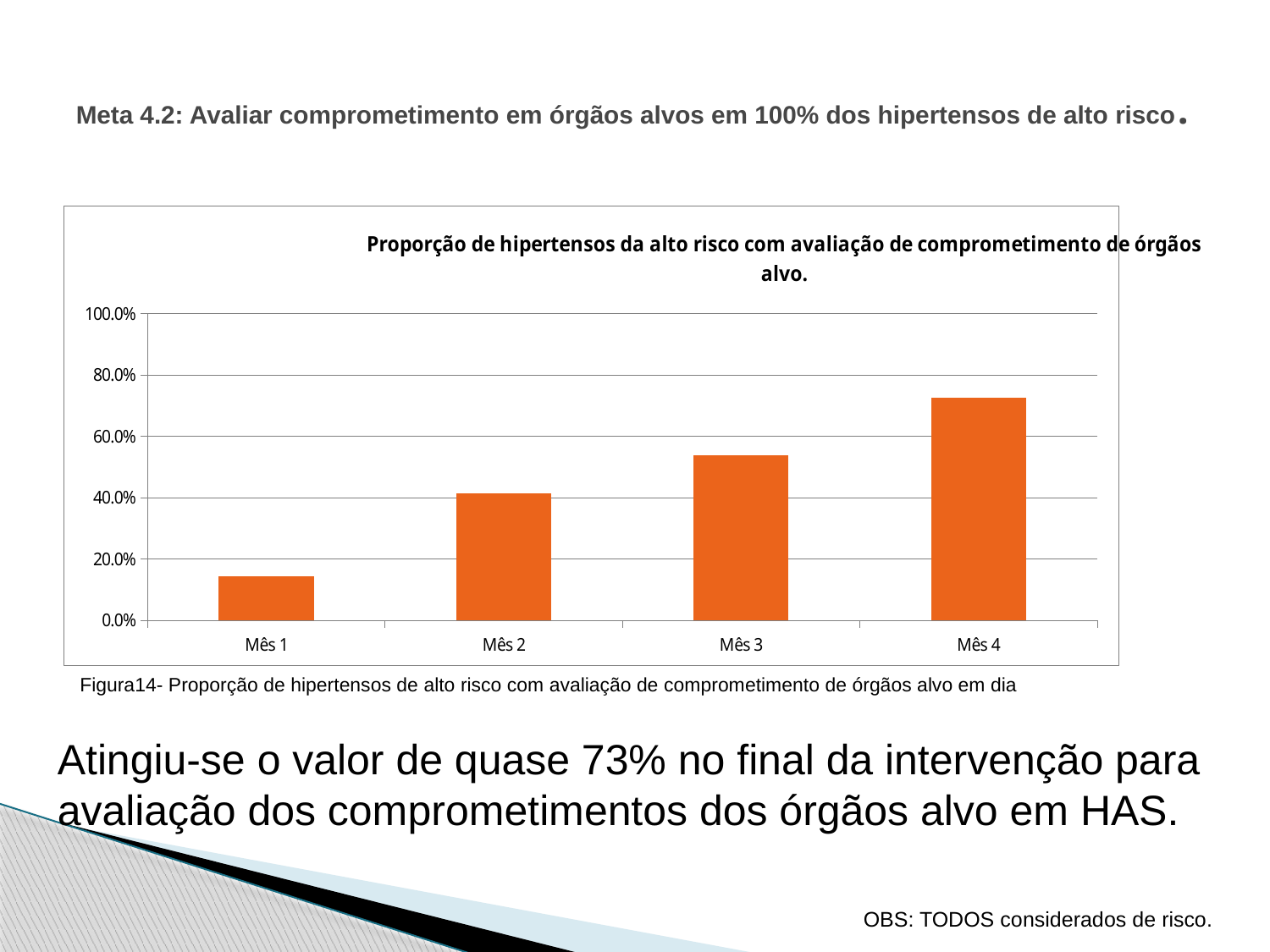
Is the value for Mês 4 greater or less than 80.0%? less Do the values rise or fall from Mês 1 to Mês 4? rise What is the title of the chart? Proporção de hipertensos da alto risco com avaliação de comprometimento de órgãos alvo. Is the value for Mês 3 greater or less than 60.0%? less How many categories (months) are plotted on the x axis? 4 Which is larger, the value for Mês 2 or the value for Mês 3? Mês 3 Is the value for Mês 1 greater or less than 20.0%? less Which month has the highest value? Mês 4 What kind of chart is shown on the slide? bar chart Which month has the lowest value? Mês 1